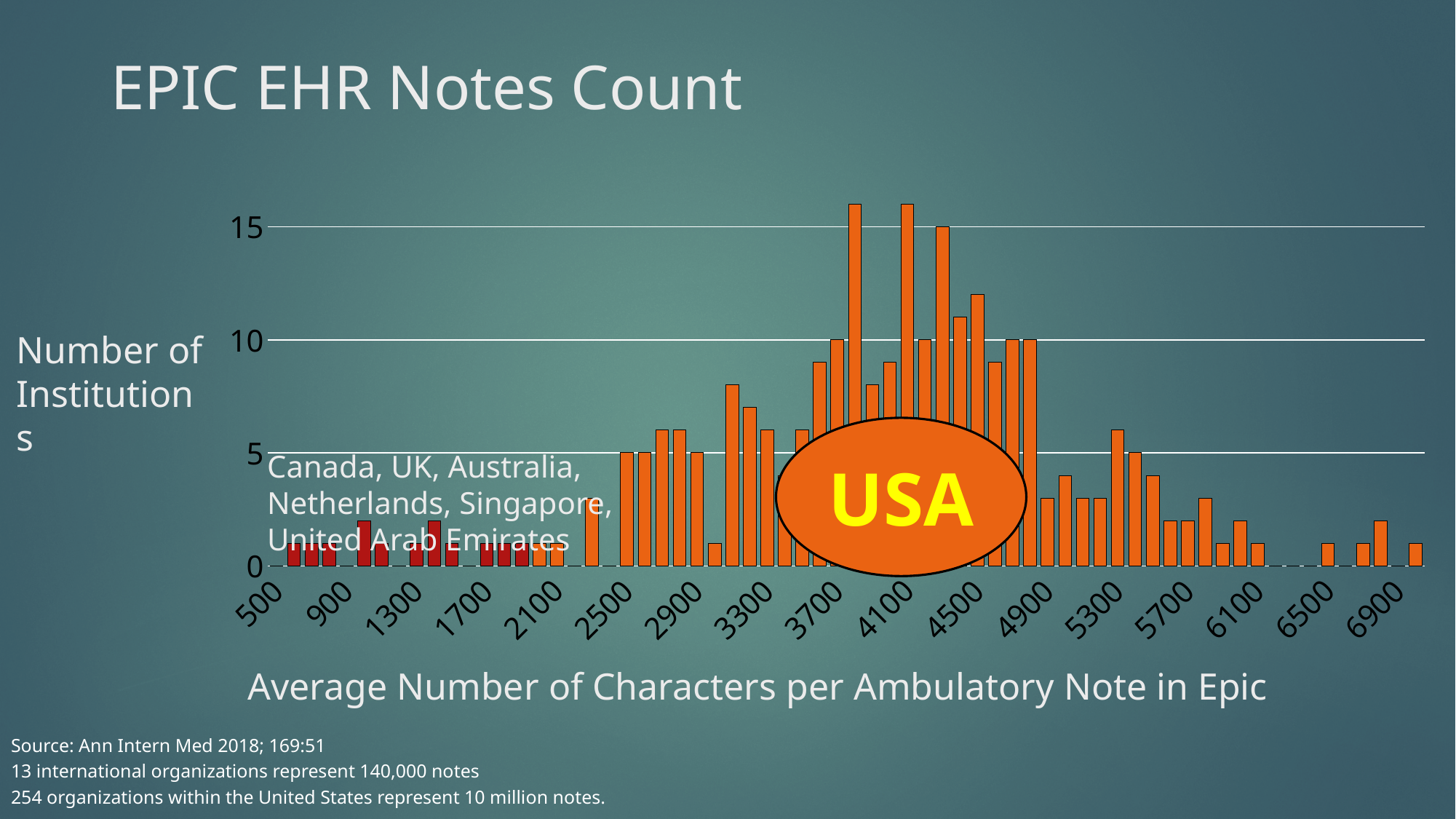
Do the bar heights generally rise or fall along the x axis from 2100 to 3700? rise Are the red bars between 500 and 2100 greater or less than 5? less Which group has the taller bars: the red international group (Canada, UK, Australia, etc.) or the orange USA group? USA Are the bars between 6100 and 6900 greater or less than 5? less What kind of chart is shown on the slide? bar chart How many labelled tick marks are on the x axis? 17 What is the x-axis title of the chart? Average Number of Characters per Ambulatory Note in Epic Do the bar heights generally rise or fall along the x axis from 4500 to 6900? fall What is the title of the chart? EPIC EHR Notes Count What is the highest value labelled on the y axis? 15 Is the tallest bar on the chart greater or less than 15? greater What is the largest value labelled on the x axis? 6900